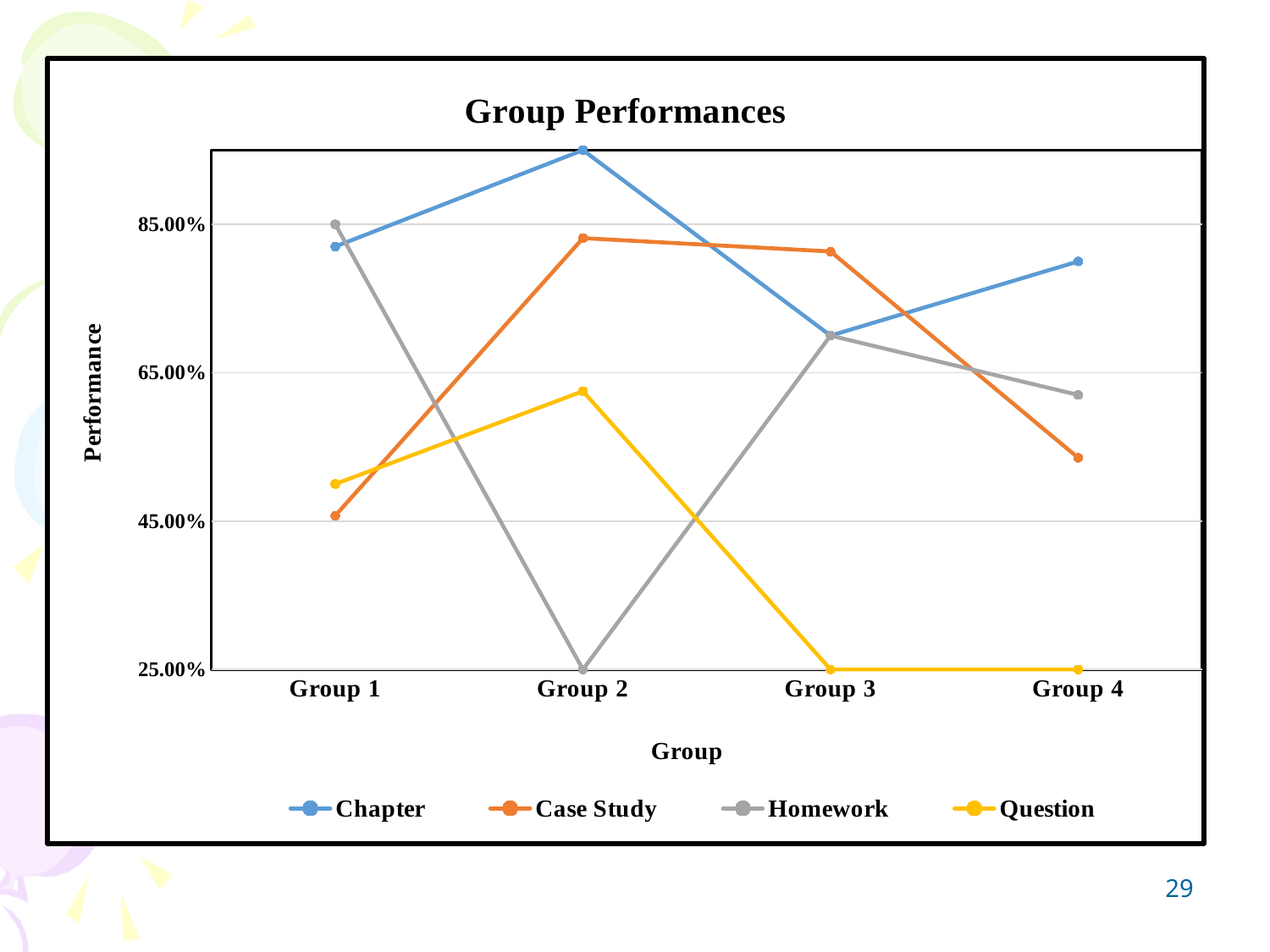
Does the Question series rise or fall from Group 2 to Group 3? fall Is the Case Study value for Group 4 greater or less than 65.00%? less How many groups are shown on the x axis? 4 For which group is the Homework value lowest? Group 2 For which group is the Chapter value highest? Group 2 What is the Homework value for Group 1? 85.00% How many series does the legend list? 4 What kind of chart is shown on the slide? line chart Is the Chapter value for Group 2 greater or less than 85.00%? greater At Group 2, which is larger: the Chapter value or the Case Study value? Chapter What is the Question value for Group 3? 25.00% What is the Homework value for Group 2? 25.00%